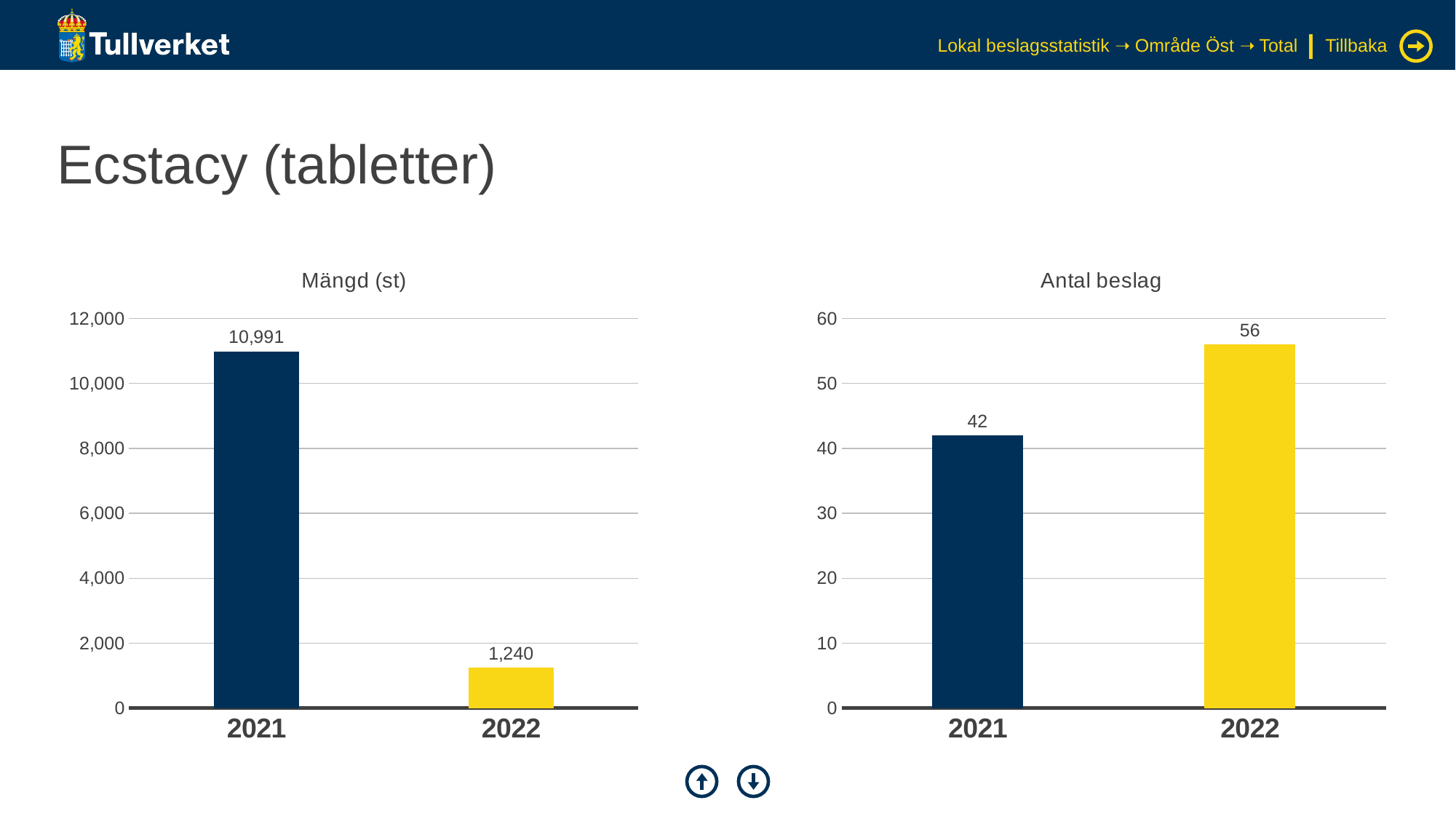
In the 'Antal beslag' chart, what is the difference between the 2022 and 2021 values? 14 In the 'Mängd (st)' chart, which year has the highest value? 2021 In the 'Mängd (st)' chart, what is the value for 2021? 10,991 In the 'Mängd (st)' chart, what is the difference between the 2021 and 2022 values? 9,751 In the 'Antal beslag' chart, what is the value for 2022? 56 In the 'Antal beslag' chart, which year has the lowest value? 2021 How many categories are shown on the x axis of the 'Antal beslag' chart? 2 In the 'Antal beslag' chart, which year has the larger value, 2021 or 2022? 2022 In the 'Mängd (st)' chart, what is the value for 2022? 1,240 In the 'Antal beslag' chart, what is the value for 2021? 42 In the 'Mängd (st)' chart, do the values rise or fall from 2021 to 2022? fall What kind of chart is the 'Mängd (st)' chart? bar chart